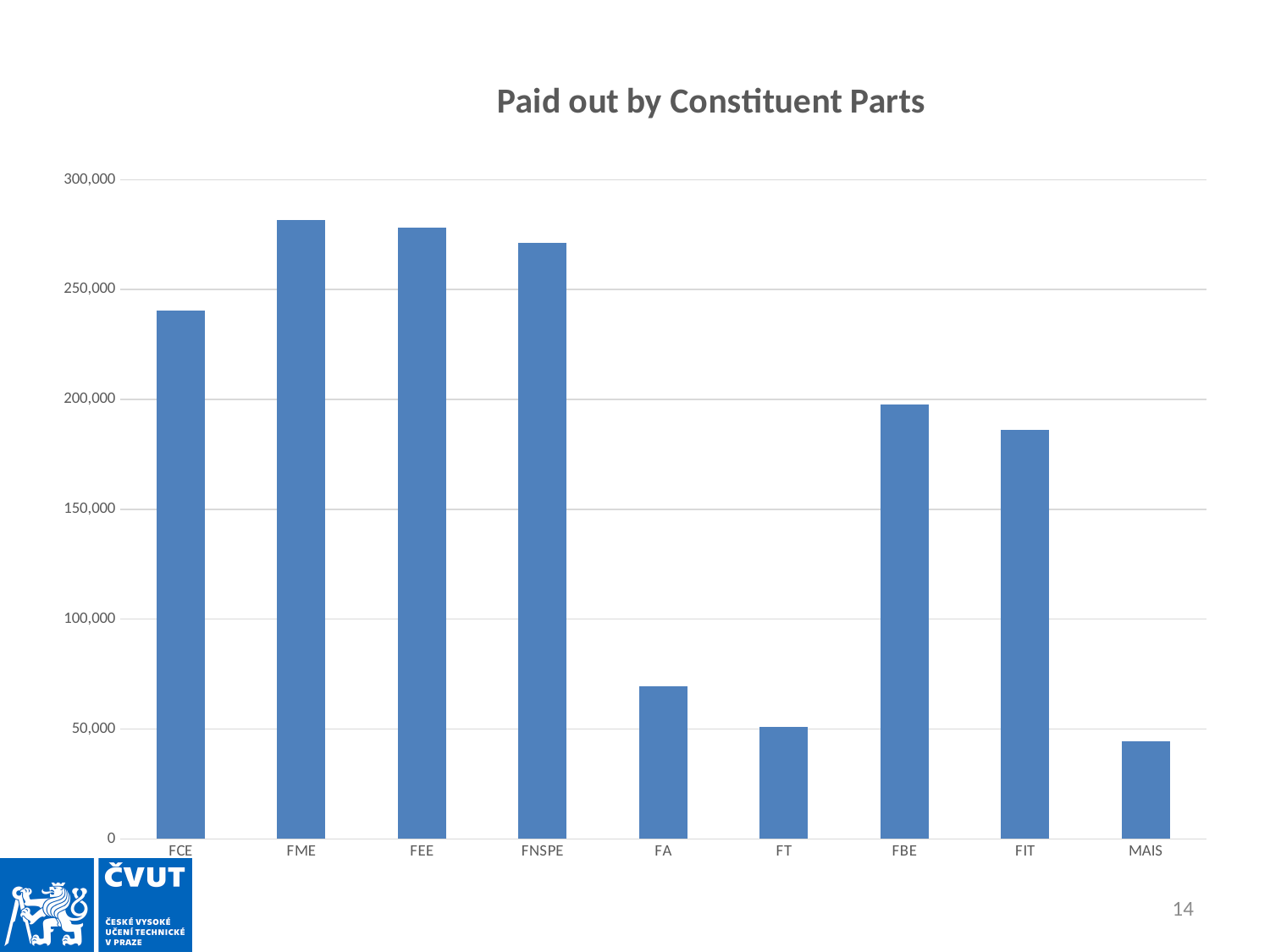
What kind of chart is shown on the slide? bar chart Which has the larger paid-out value, FA or FT? FA Which constituent part has the lowest paid-out value? MAIS How many constituent parts are shown on the x axis of the chart? 9 Is the value for FME greater or less than 250,000? greater What is the title of the chart? Paid out by Constituent Parts Is the value for FIT greater or less than 200,000? less Which has the larger paid-out value, FCE or FBE? FCE Is the value for FA greater or less than 50,000? greater Which has the larger paid-out value, FBE or FIT? FBE